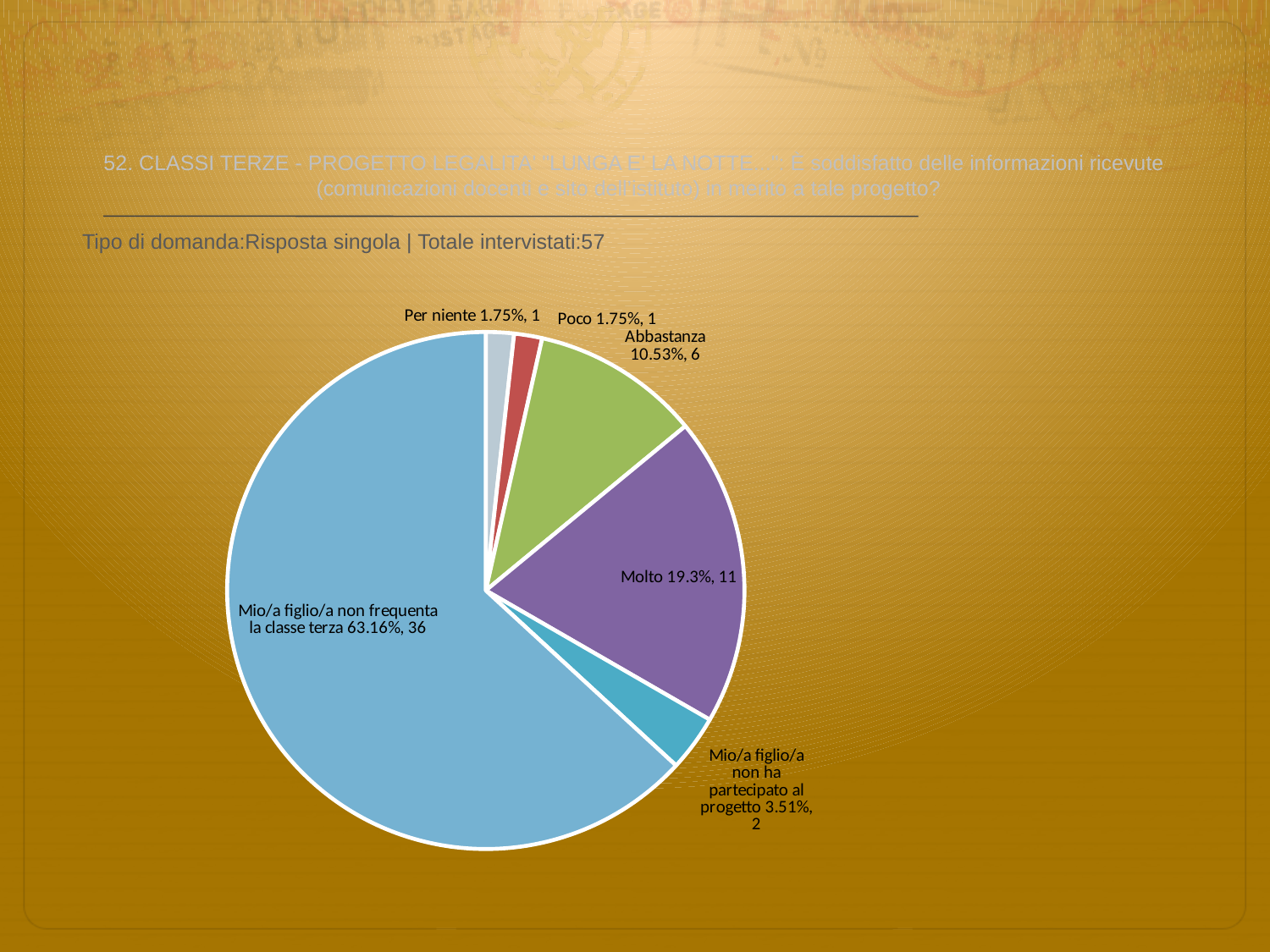
What percentage is shown for "Mio/a figlio/a non frequenta la classe terza"? 63.16% What percentage is shown for the "Poco" slice? 1.75% What percentage is shown for the "Molto" slice? 19.3% Which slice is larger, "Molto" or "Abbastanza"? Molto What is the total number of respondents stated on the slide? 57 What is the difference in number of respondents between "Molto" and "Abbastanza"? 5 How many slices does the pie chart have? 6 What kind of chart is shown on the slide? pie chart What is the combined number of respondents for "Per niente" and "Poco"? 2 How many respondents answered "Abbastanza"? 6 How many respondents answered "Mio/a figlio/a non ha partecipato al progetto"? 2 Which slice is the largest in the pie chart? Mio/a figlio/a non frequenta la classe terza